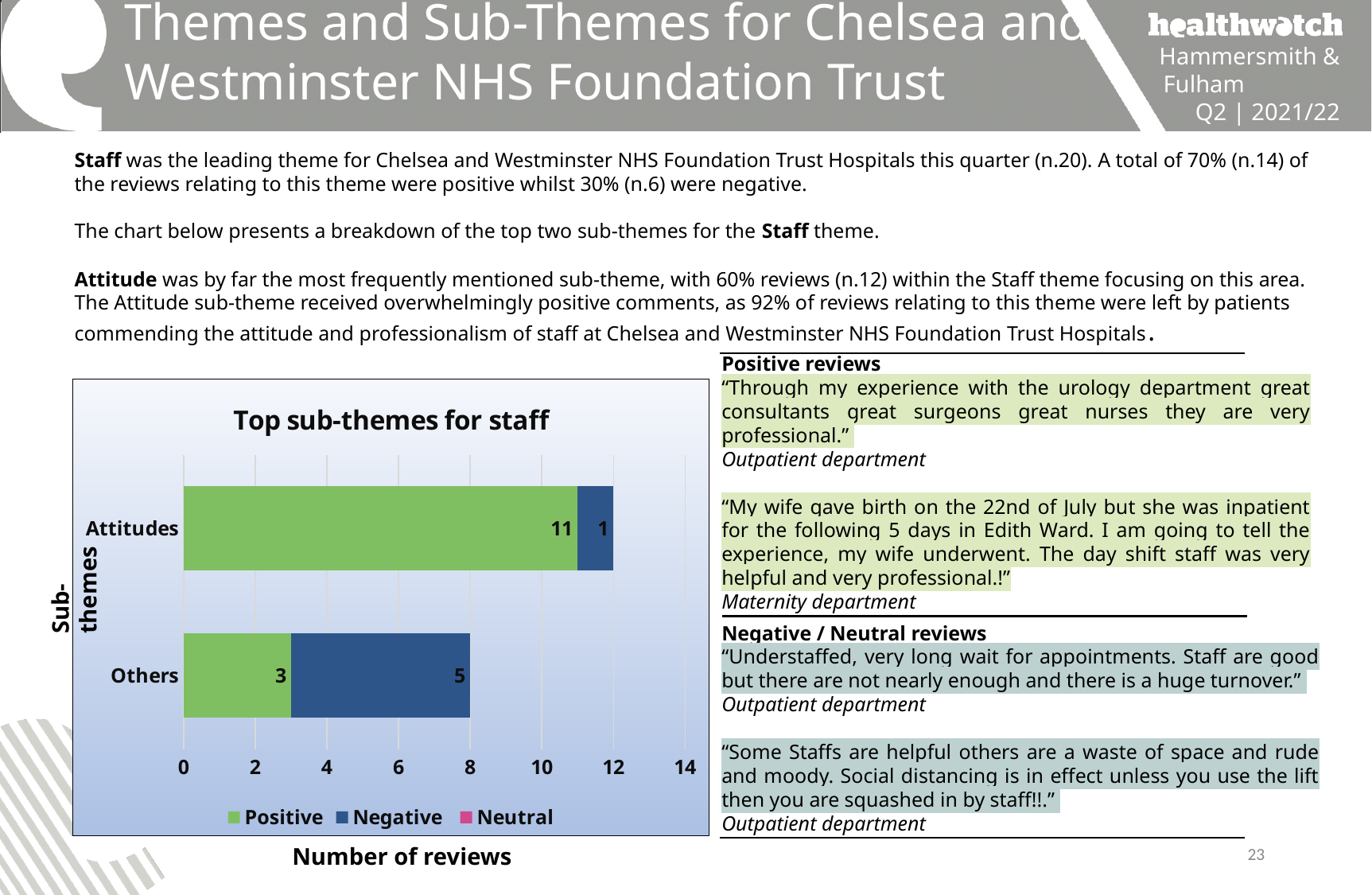
What is the Positive value for Attitudes? 11 How many sub-themes are shown on the chart? 2 What type of chart is shown? Bar chart What is the total number of reviews in the Others bar? 8 What is the Positive value for Others? 3 How many series does the legend list? 3 Which sub-theme has the lower Negative value? Attitudes What is the total number of reviews in the Attitudes bar? 12 What is the Negative value for Others? 5 What is the difference between the Positive values for Attitudes and Others? 8 What is the Negative value for Attitudes? 1 Which sub-theme has the higher Positive value? Attitudes